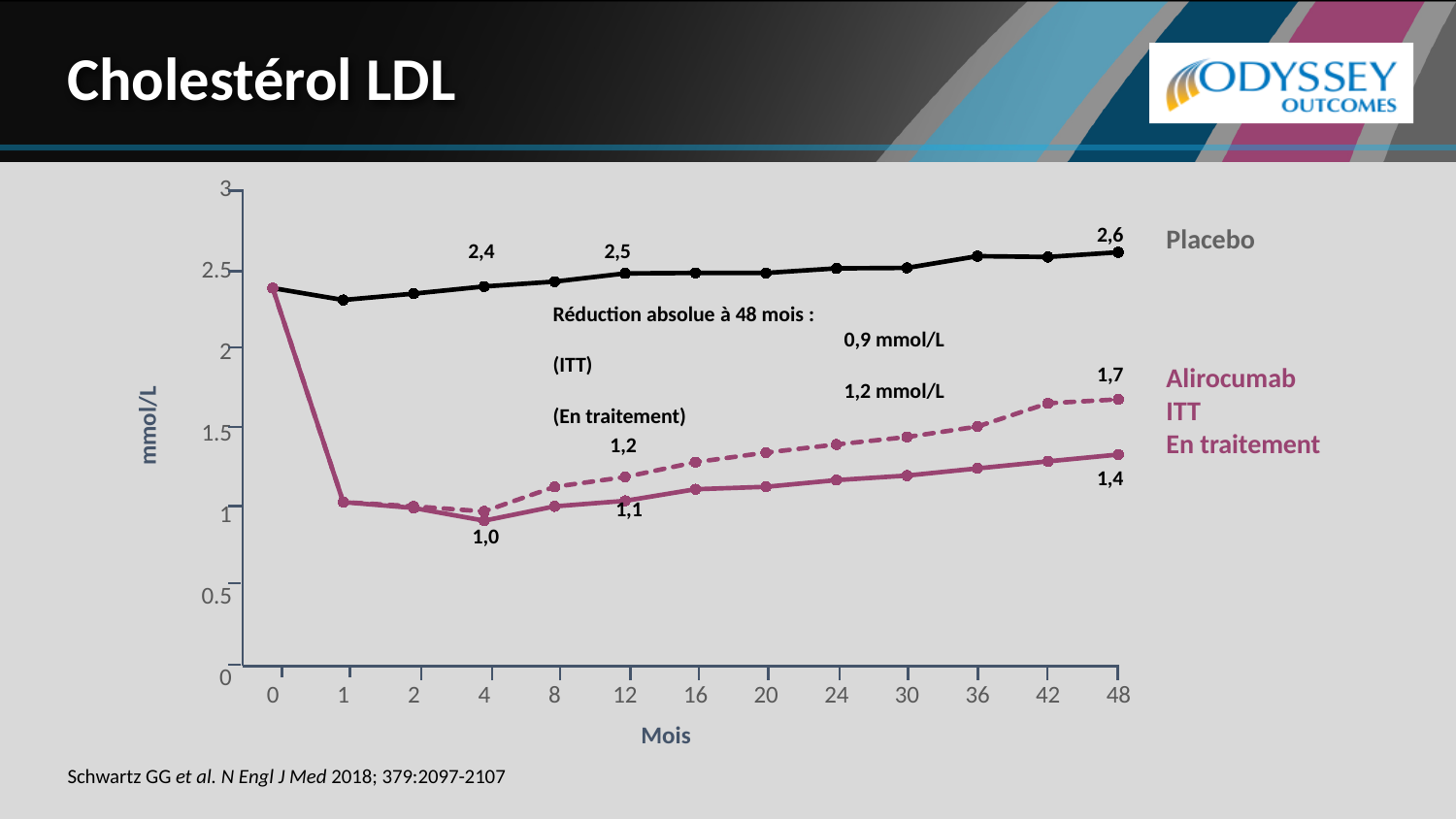
What is the value for Alirocumab ITT at 48 months? 1,7 What is the difference between the Placebo and Alirocumab En traitement values at 48 months? 1,2 What is the value for Alirocumab En traitement at 48 months? 1,4 Does the Alirocumab En traitement line rise or fall between 4 months and 48 months? rise What type of chart is shown on the slide? line chart Is the Placebo value at 0 months greater or less than 2? greater What is the difference between the Placebo and Alirocumab ITT values at 48 months? 0,9 What is the value for Placebo at 12 months? 2,5 Which series has the highest value at 48 months? Placebo What is the LDL cholesterol value for Placebo at 48 months? 2,6 What is the label of the y axis? mmol/L What is the value for Alirocumab En traitement at 4 months? 1,0